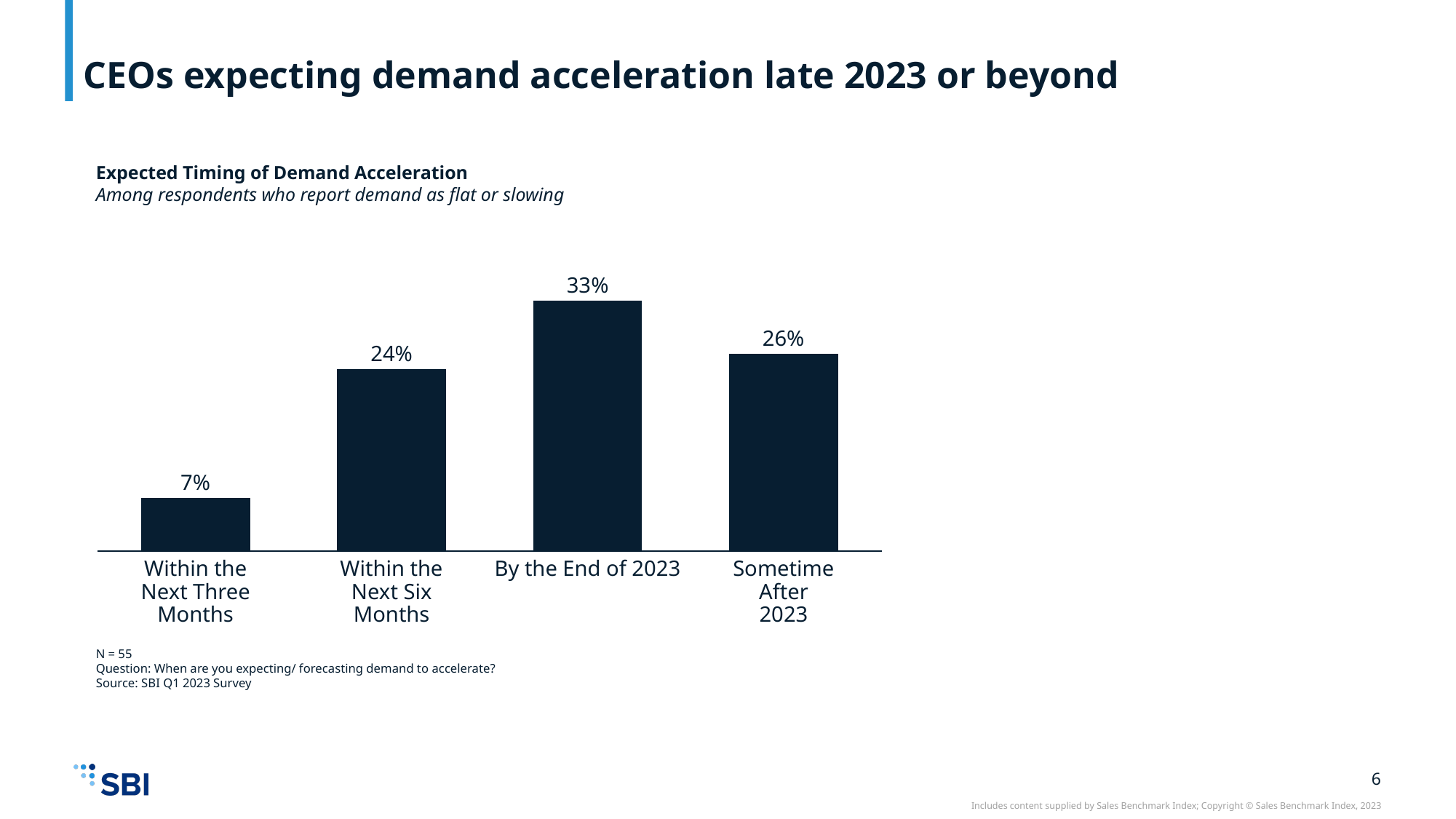
What is the difference between the values for 'Sometime After 2023' and 'Within the Next Three Months'? 19% Which category has the highest value? By the End of 2023 What kind of chart is shown on the slide? Bar chart What is the value for 'By the End of 2023'? 33% What is the title of the chart? Expected Timing of Demand Acceleration What is the value for 'Within the Next Three Months'? 7% Which is larger: the value for 'Sometime After 2023' or 'Within the Next Six Months'? Sometime After 2023 How many categories are shown in the chart? 4 What is the difference between the values for 'By the End of 2023' and 'Within the Next Six Months'? 9% What is the value for 'Sometime After 2023'? 26% Which category has the lowest value? Within the Next Three Months What is the value for 'Within the Next Six Months'? 24%